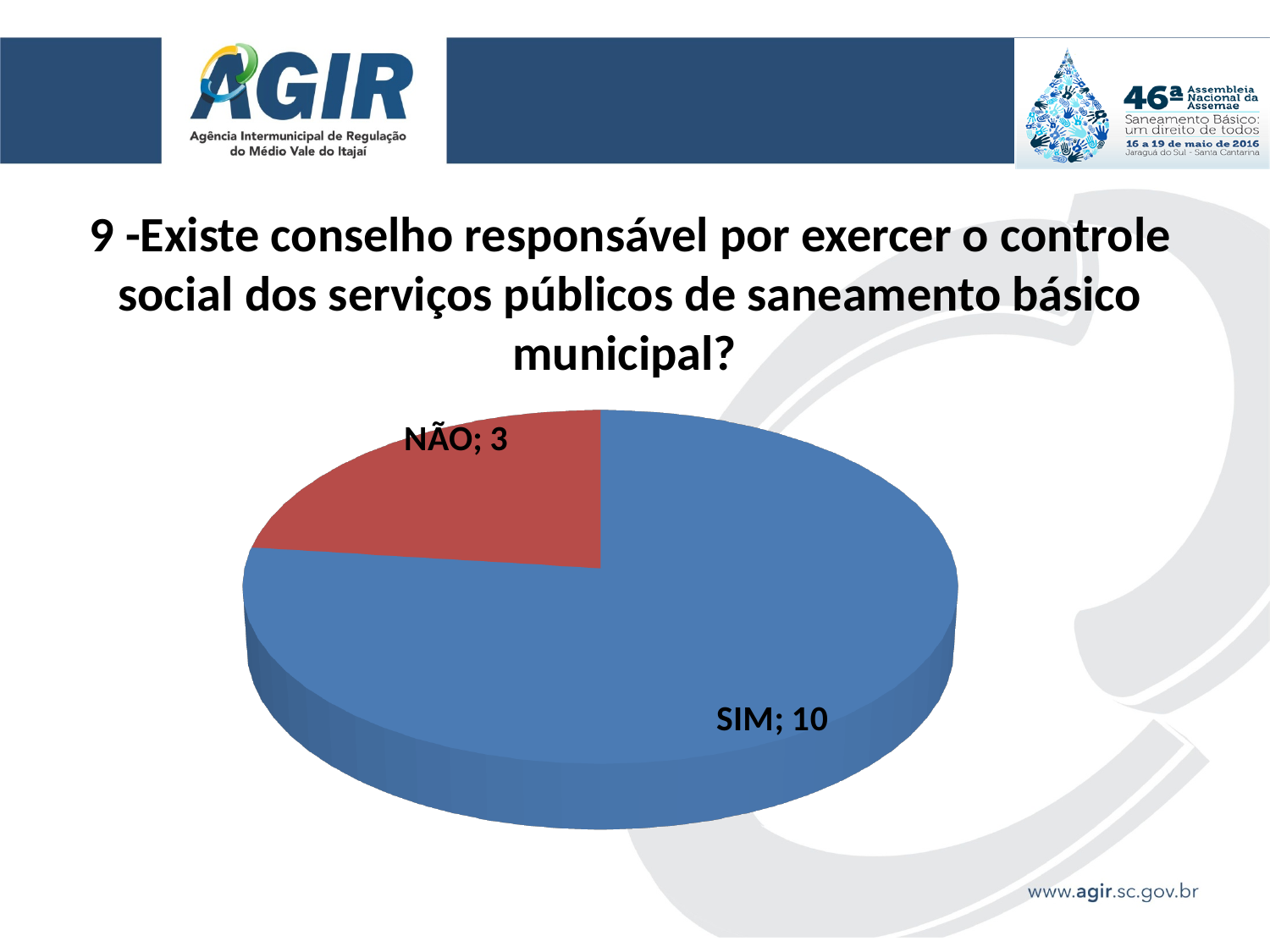
What is the value for SIM? 10 Which category has the largest slice? SIM What colour is the SIM slice? blue What kind of chart is shown on the slide? pie chart What is the difference between the values for SIM and NÃO? 7 How many slices does the pie chart have? 2 What is the total of all slices in the pie chart? 13 Which category has the smallest slice? NÃO What colour is the NÃO slice? red Which is larger, the value for SIM or the value for NÃO? SIM What is the value for NÃO? 3